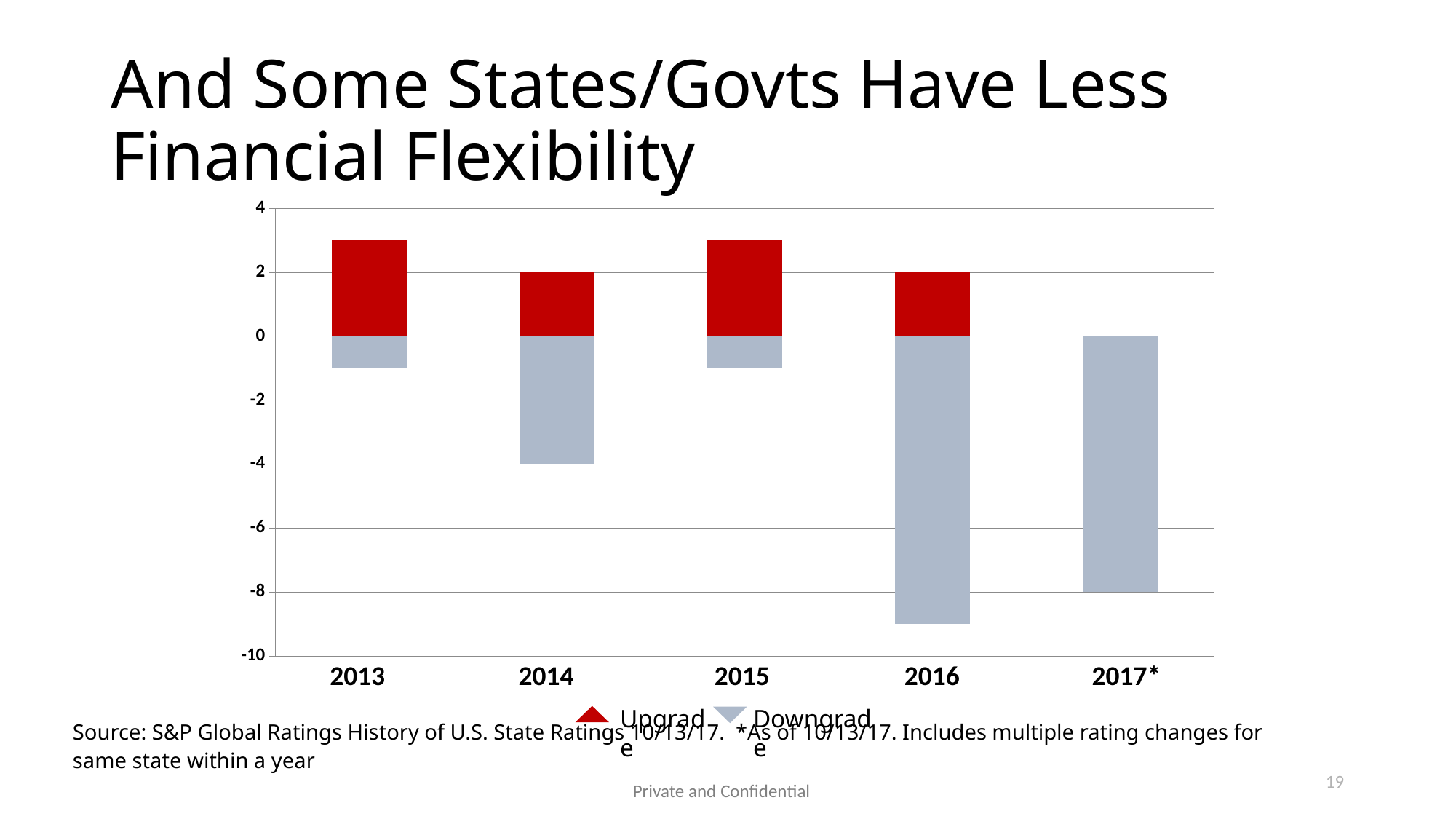
What is the Upgrade value for 2016? 2 Which year shows no Upgrade bar at all? 2017* Is the Upgrade value for 2013 greater or less than 2? greater How many series does the chart legend list? 2 Which series is shown in red in the chart? Upgrade Which year has the largest Downgrade bar (most negative value)? 2016 What is the Downgrade value for 2017*? -8 What is the Downgrade value for 2014? -4 How many years are shown on the x axis of the chart? 5 Is the Downgrade value for 2016 greater or less than -8? less What kind of chart is shown on the slide? bar chart What is the Upgrade value for 2014? 2